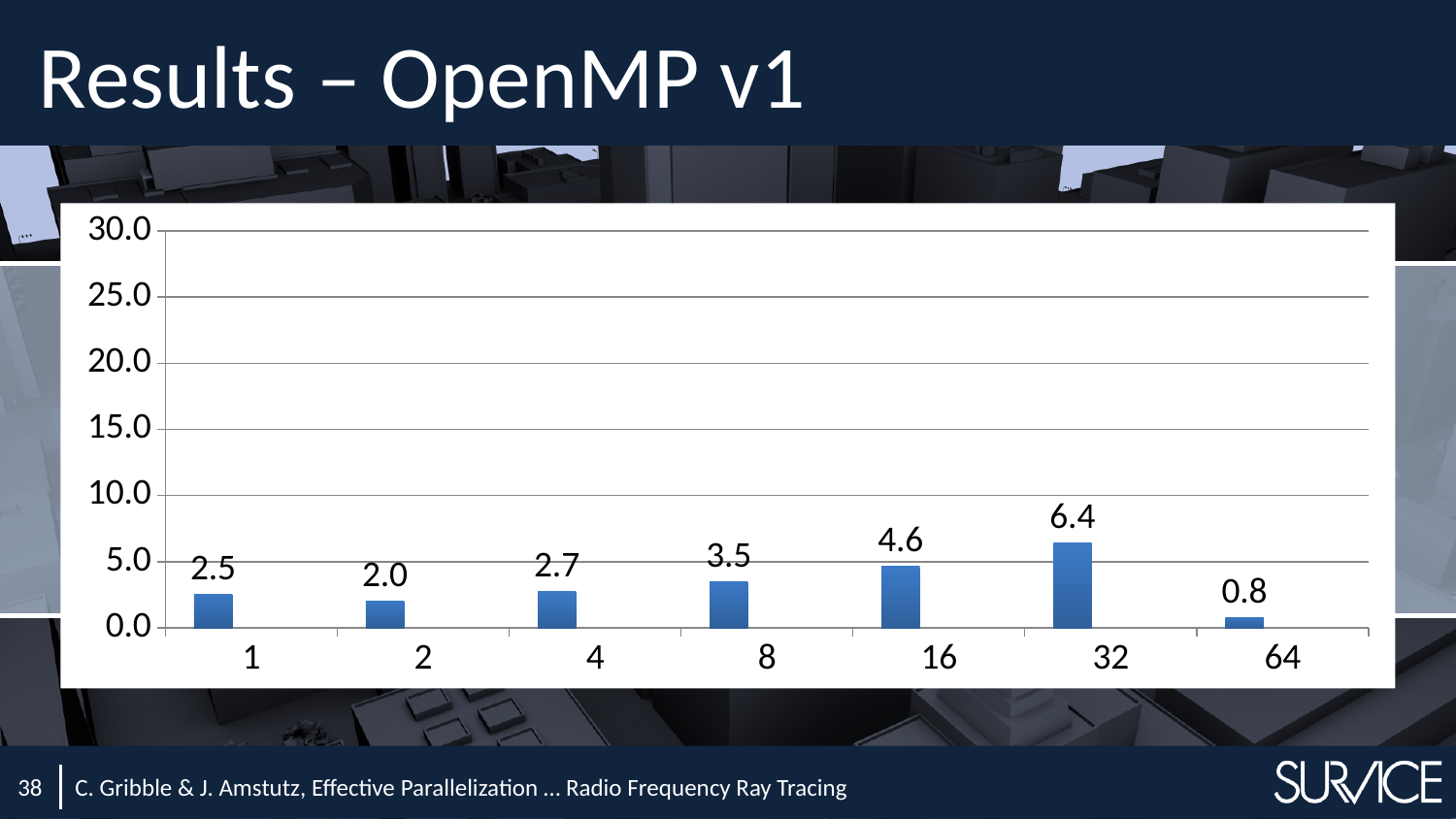
What is the value for category 32? 6.4 What is the value for category 64? 0.8 Which is larger, the value for 2 or the value for 4? 4 What is the value for category 8? 3.5 Which category has the lowest value? 64 Which category has the highest value? 32 What is the value for category 1? 2.5 Is the value for 32 greater or less than 5.0? greater What is the difference between the values for 32 and 16? 1.8 What kind of chart is shown on the slide? bar chart What is the highest value shown on the y axis? 30.0 How many categories are shown on the x axis? 7